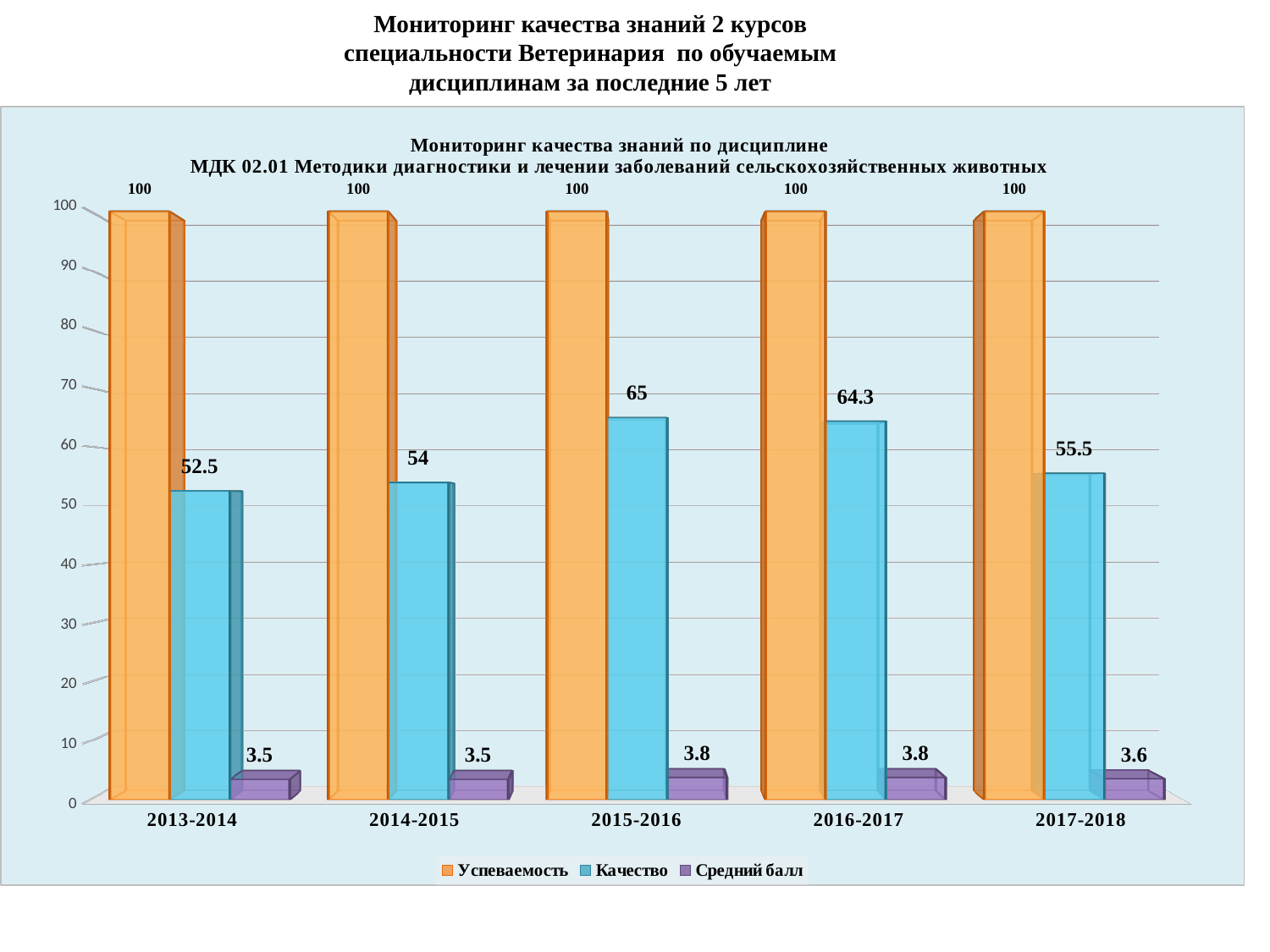
What kind of chart is shown? bar chart Which year has the highest value for Качество? 2015-2016 Which series is shown in purple in the legend? Средний балл What is the value of Качество for 2015-2016? 65 Is the Качество value for 2014-2015 greater or less than 60? less How many series does the legend list? 3 How many years are shown on the x axis? 5 What is the difference between the Качество values for 2015-2016 and 2013-2014? 12.5 What is the value of Средний балл for 2017-2018? 3.6 Which is larger, the Качество value for 2016-2017 or for 2017-2018? 2016-2017 What is the value of Успеваемость for 2014-2015? 100 Which year has the lowest value for Качество? 2013-2014